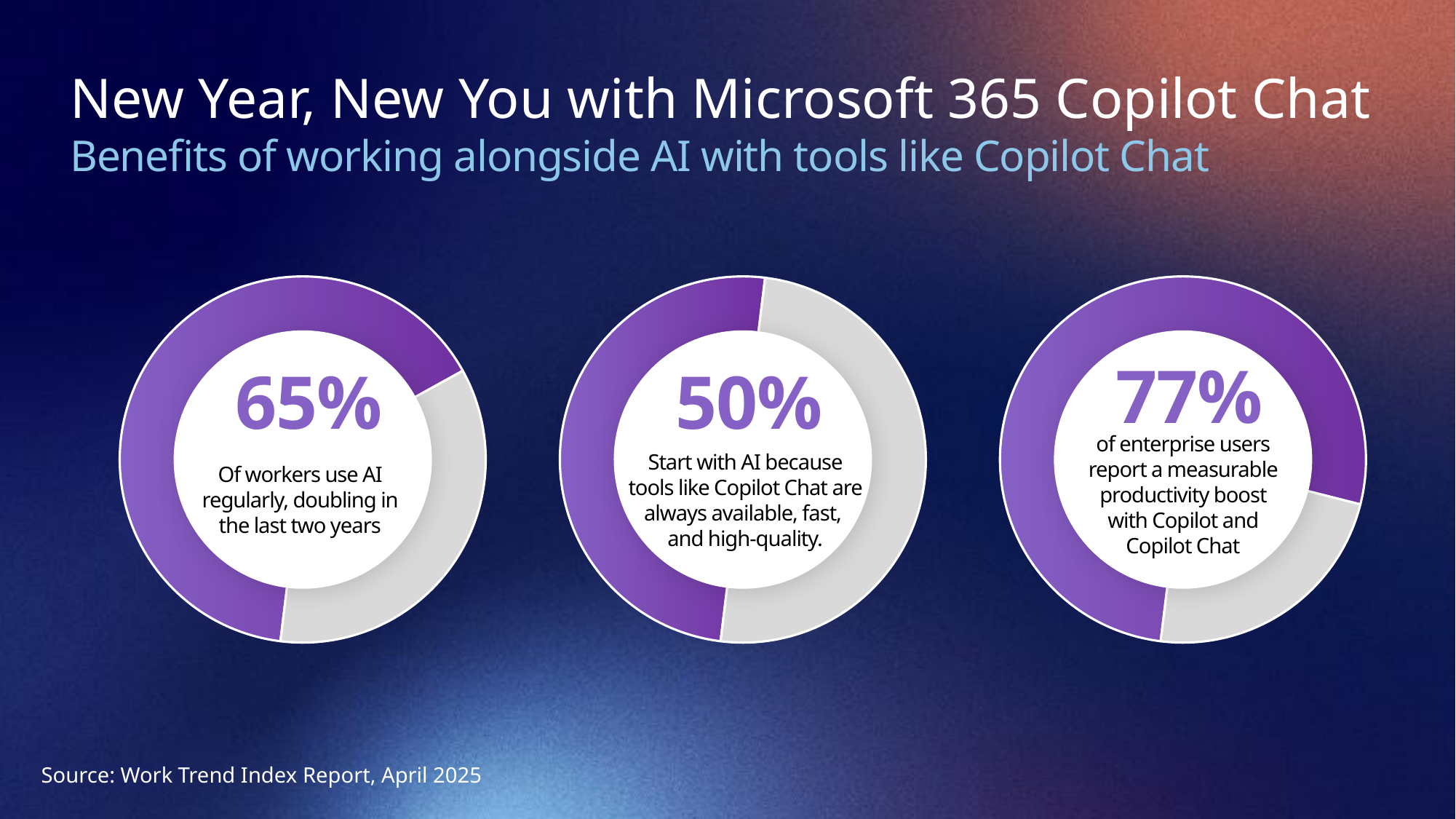
On the middle donut chart, what share of the ring is filled in purple? 50% What colour is used for the filled portion of each donut chart? Purple On the middle donut chart, what percentage start with AI because tools like Copilot Chat are always available, fast, and high-quality? 50% On the right donut chart, what percentage of enterprise users report a measurable productivity boost with Copilot and Copilot Chat? 77% How many donut charts are on the slide? 3 What kind of charts are shown on the slide? Donut charts What is the source cited for the data on the slide? Work Trend Index Report, April 2025 Which of the three donut charts shows the lowest percentage? The middle chart (50%) What is the difference between the percentage on the right donut chart and the percentage on the left donut chart? 12% On the left donut chart, what percentage of workers use AI regularly? 65% Which of the three donut charts shows the highest percentage? The right chart (77%) Which is larger: the percentage on the left donut chart or the percentage on the middle donut chart? The left chart (65%)